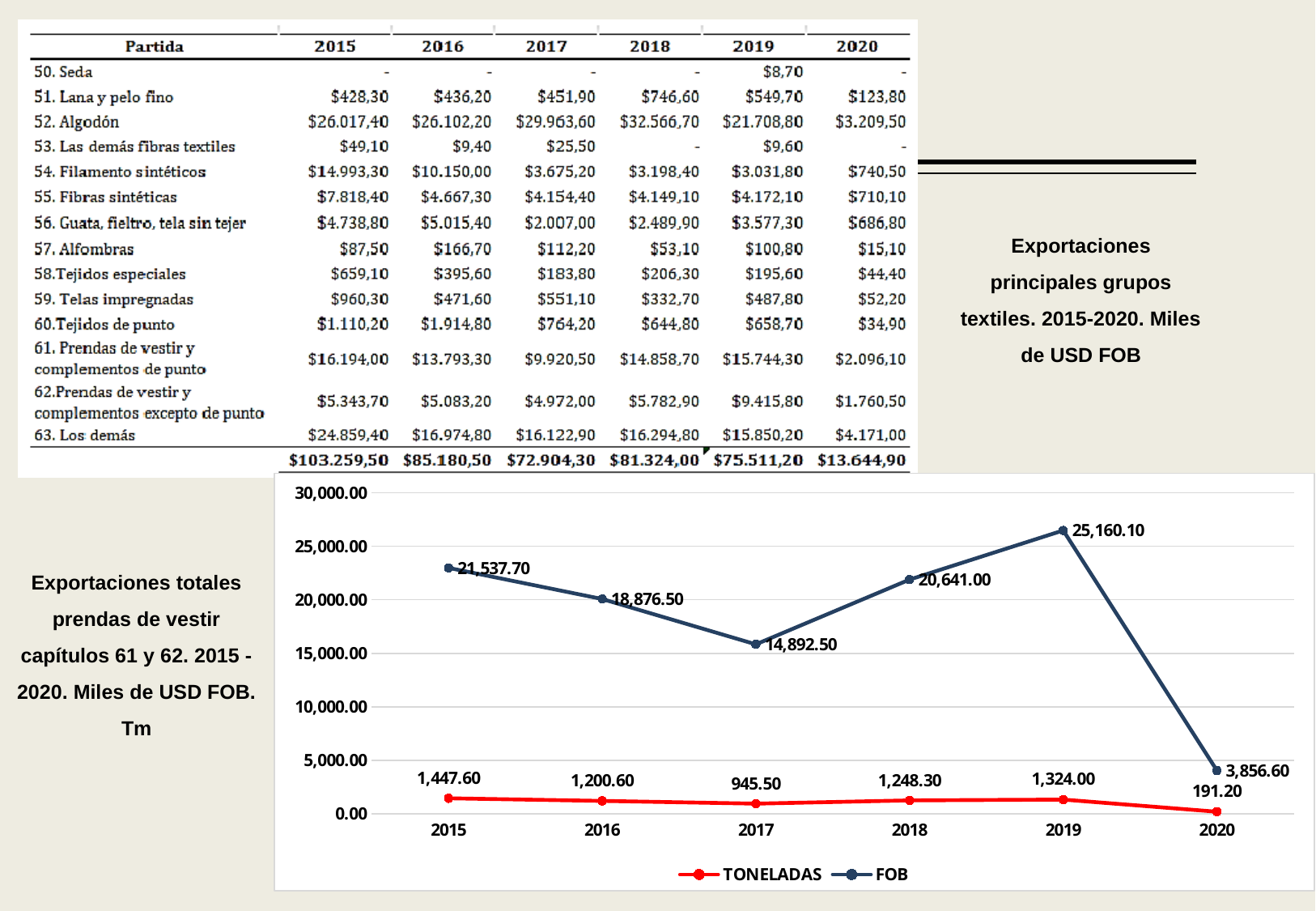
What is the FOB value for 2019 in the line chart? 25,160.10 How many years are plotted on the x axis of the line chart? 6 Does the FOB series rise or fall between 2019 and 2020 in the line chart? fall Which is larger in the line chart: the FOB value for 2015 or the FOB value for 2016? 2015 What is the TONELADAS value for 2017 in the line chart? 945.50 What is the FOB value for 2020 in the line chart? 3,856.60 What colour is the TONELADAS line in the chart? red In which year is the FOB series highest in the line chart? 2019 In which year is the TONELADAS series lowest in the line chart? 2020 How many series does the legend of the line chart list? 2 What is the difference between the FOB values for 2019 and 2018 in the line chart? 4,519.10 What type of chart is shown at the bottom of the slide? line chart